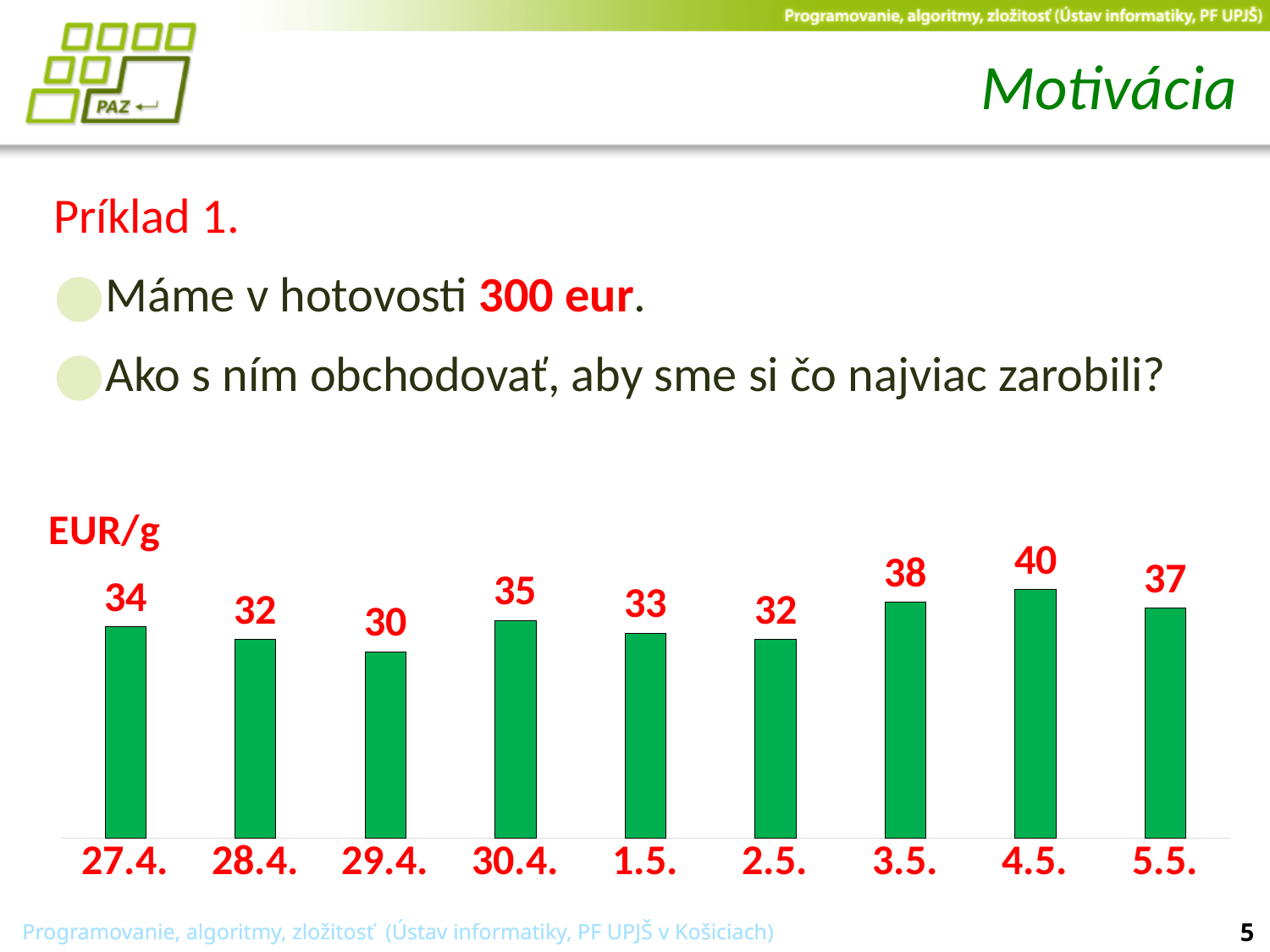
Do the values rise or fall from 2.5. to 4.5.? rise What kind of chart is shown on the slide? bar chart What is the value for 27.4.? 34 What unit label is shown above the chart? EUR/g Which is larger, the value for 28.4. or the value for 30.4.? 30.4. What is the difference between the values for 4.5. and 29.4.? 10 What is the difference between the values for 30.4. and 1.5.? 2 Which date has the highest value? 4.5. Which date has the lowest value? 29.4. How many dates are shown on the x axis? 9 What is the value for 3.5.? 38 What is the value for 5.5.? 37